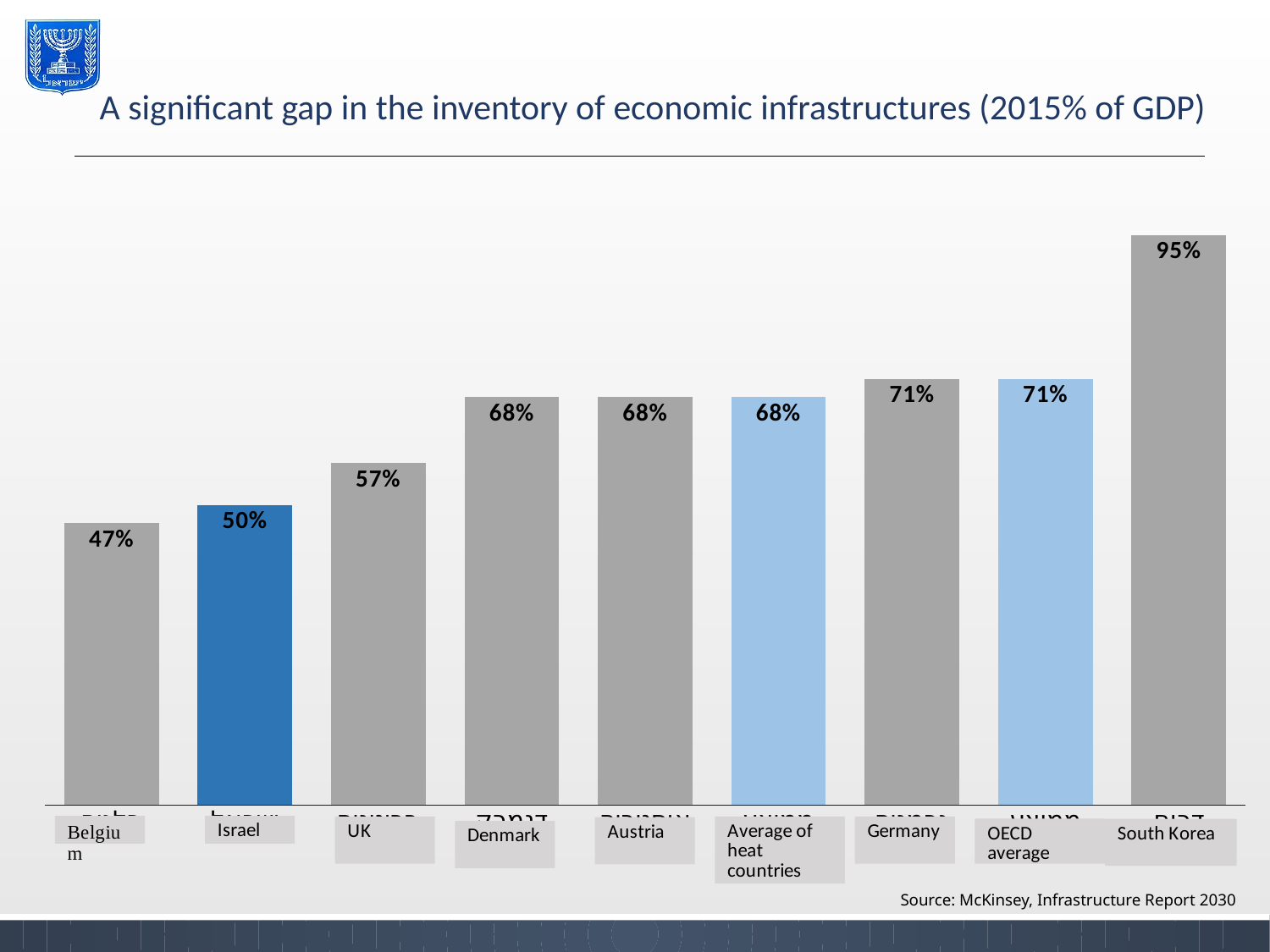
Which category has the highest value? South Korea What kind of chart is shown on the slide? Bar chart What is the value for the UK? 57% How many bars are shown in the chart? 9 Which category has the lowest value? Belgium Which bar is coloured dark blue? Israel What is the value for the OECD average? 71% What is the difference between the OECD average and Israel? 21% What is the value for Israel? 50% Which is larger, the value for Germany or the value for Denmark? Germany What is the value for South Korea? 95% What is the difference between the values for South Korea and Israel? 45%